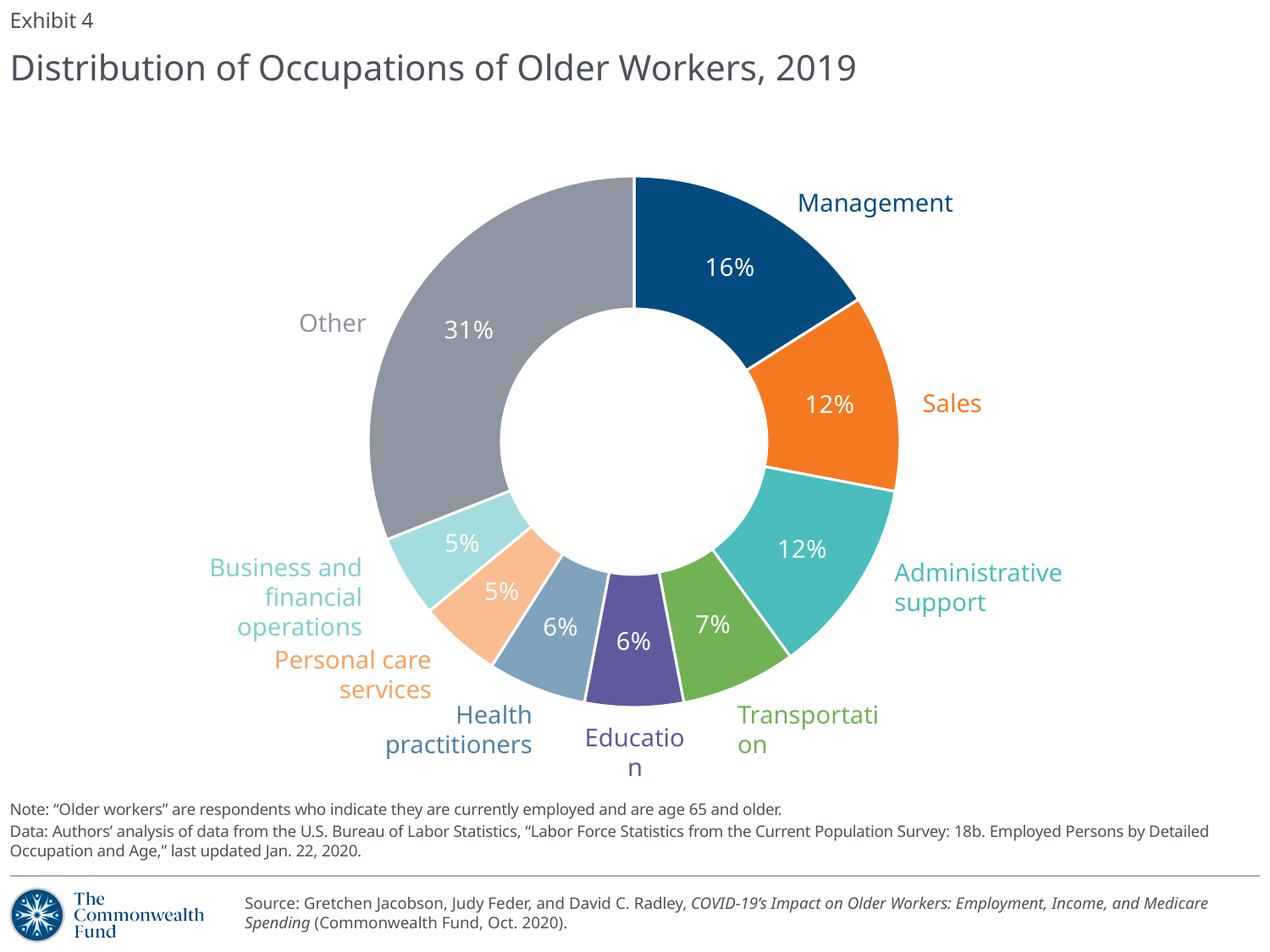
Which is larger, the share for Management or the share for Administrative support? Management What share is shown for Personal care services? 5% What is the value shown for Transportation? 7% What percentage of older workers work in Sales? 12% What is the title of the chart? Distribution of Occupations of Older Workers, 2019 What is the combined share of Sales and Administrative support? 24% Which is larger, the share for Transportation or the share for Business and financial operations? Transportation What share of older workers are in Management occupations? 16% How many occupation categories are shown in the chart? 9 What is the difference in percentage points between Management and Education? 10 What kind of chart is shown on the slide? Pie (donut) chart Which category has the largest share of the chart? Other